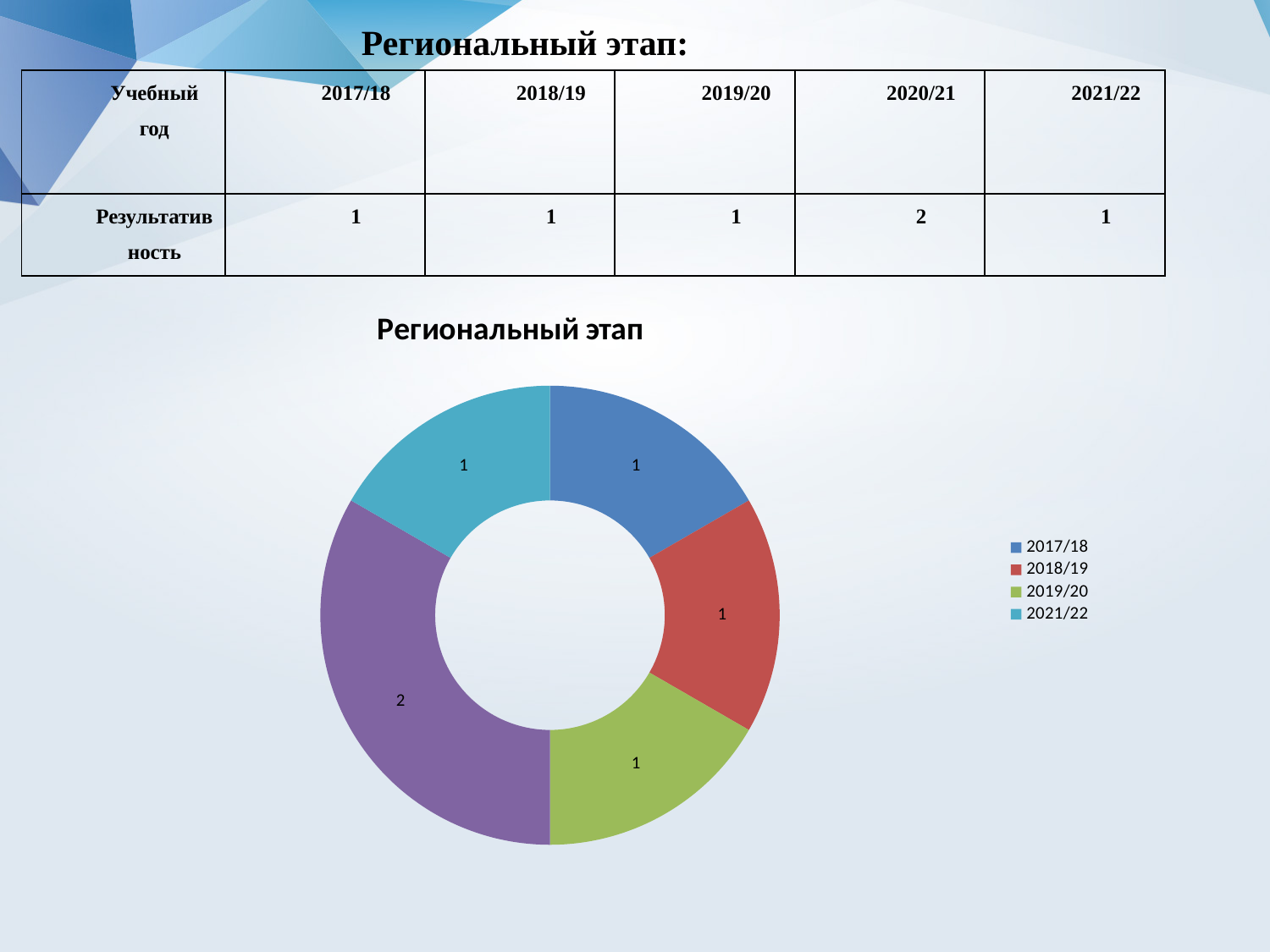
What is the value shown for 2021/22 in the chart? 1 What is the value shown for 2018/19 in the chart? 1 How many slices does the doughnut chart have? 5 What is the title of the chart? Региональный этап What is the total of all the values shown on the chart slices? 6 What is the value shown for 2017/18 in the chart? 1 What is the value of the largest slice in the chart? 2 What kind of chart is shown on the slide? Doughnut chart How many entries does the chart legend list? 4 What is the value shown on the purple slice of the chart? 2 What is the difference between the largest slice value and the value for 2017/18? 1 What is the value shown for 2019/20 in the chart? 1